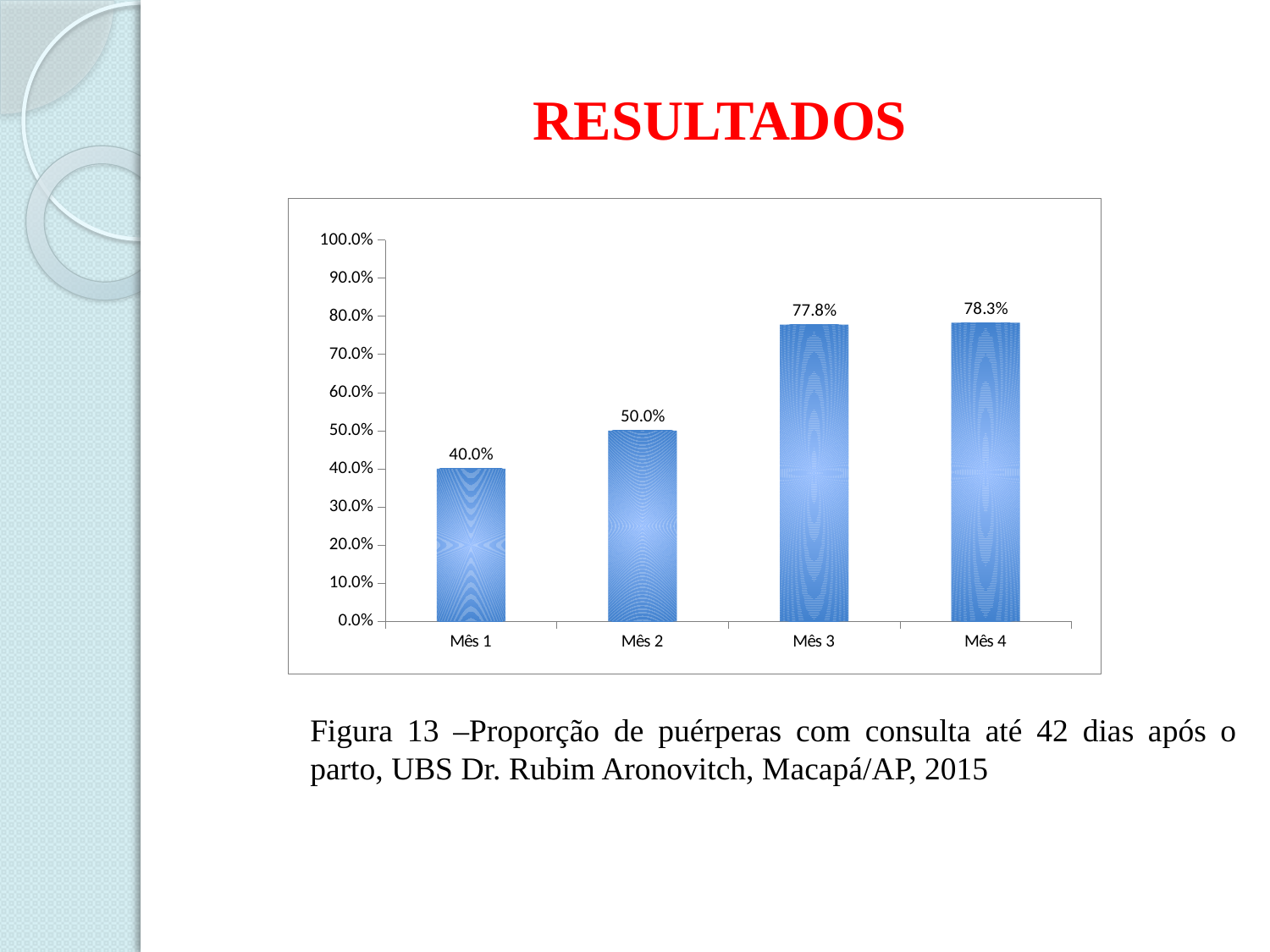
Is the value for Mês 2 greater or less than 60.0%? less What is the value for Mês 1? 40.0% What kind of chart is shown on the slide? bar chart What is the difference between the values for Mês 2 and Mês 1? 10.0% Which month has the lowest value? Mês 1 What is the figure number given in the caption below the chart? Figura 13 What is the difference between the values for Mês 4 and Mês 3? 0.5% What is the value for Mês 3? 77.8% What is the value for Mês 4? 78.3% Do the values rise or fall from Mês 1 to Mês 4? rise How many months are shown on the x axis? 4 Which is larger, the value for Mês 2 or the value for Mês 3? Mês 3